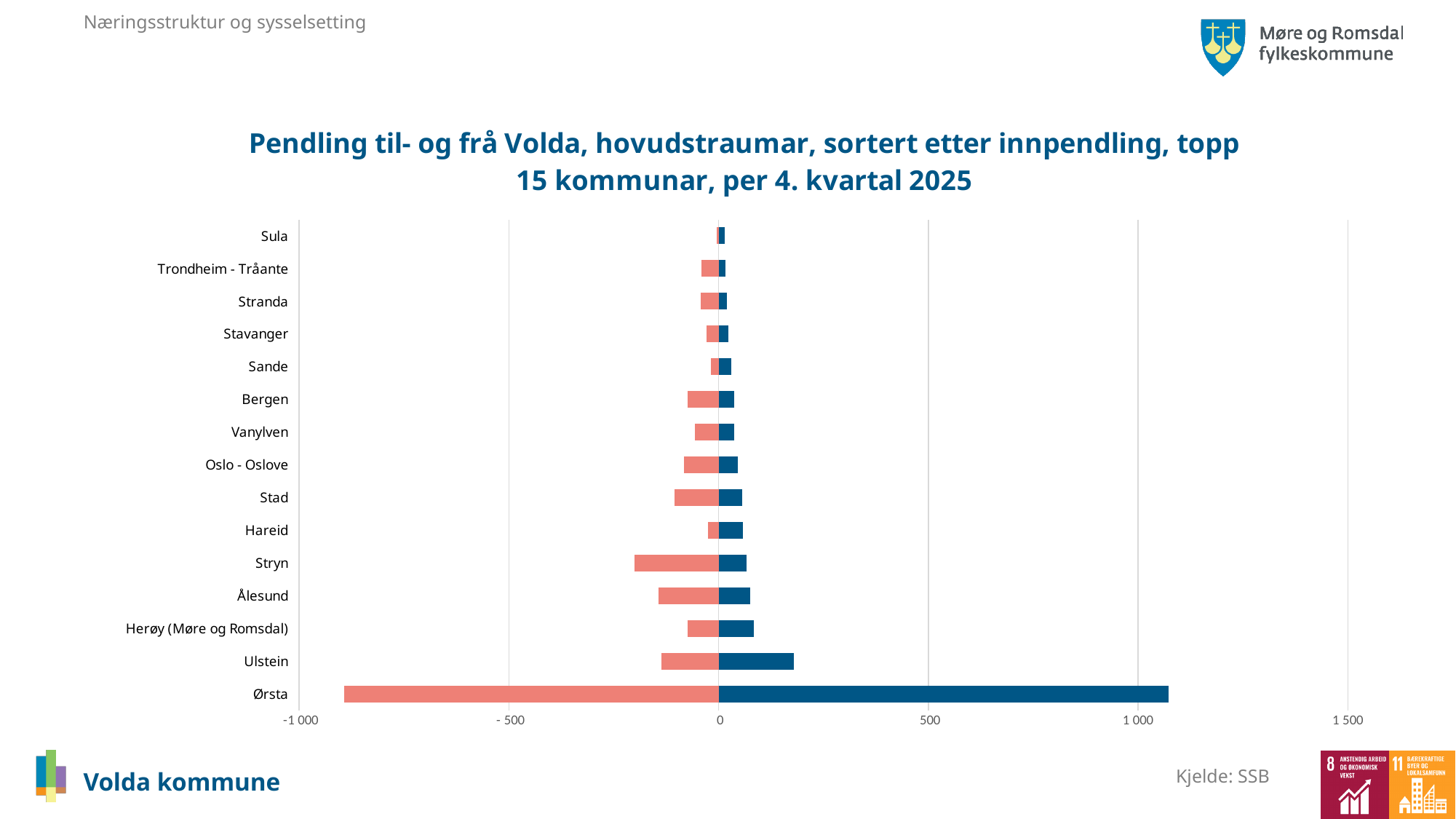
Which municipality has the shortest blue bar in the chart? Sula What kind of chart is shown on the slide? bar chart Is the blue bar for Ørsta greater or less than 1 000? greater What is the highest value shown on the horizontal axis of the chart? 1 500 Which municipality has the longest blue bar (highest innpendling) in the chart? Ørsta How many municipalities (categories) are listed on the vertical axis of the chart? 15 Which has the longer blue bar, Ulstein or Herøy (Møre og Romsdal)? Ulstein Which municipality is listed at the top of the vertical axis? Sula Is the red bar for Ørsta beyond -500 (further from zero) or not? beyond -500 Which has the longer red bar, Stryn or Hareid? Stryn Is the blue bar for Ulstein greater or less than 500? less